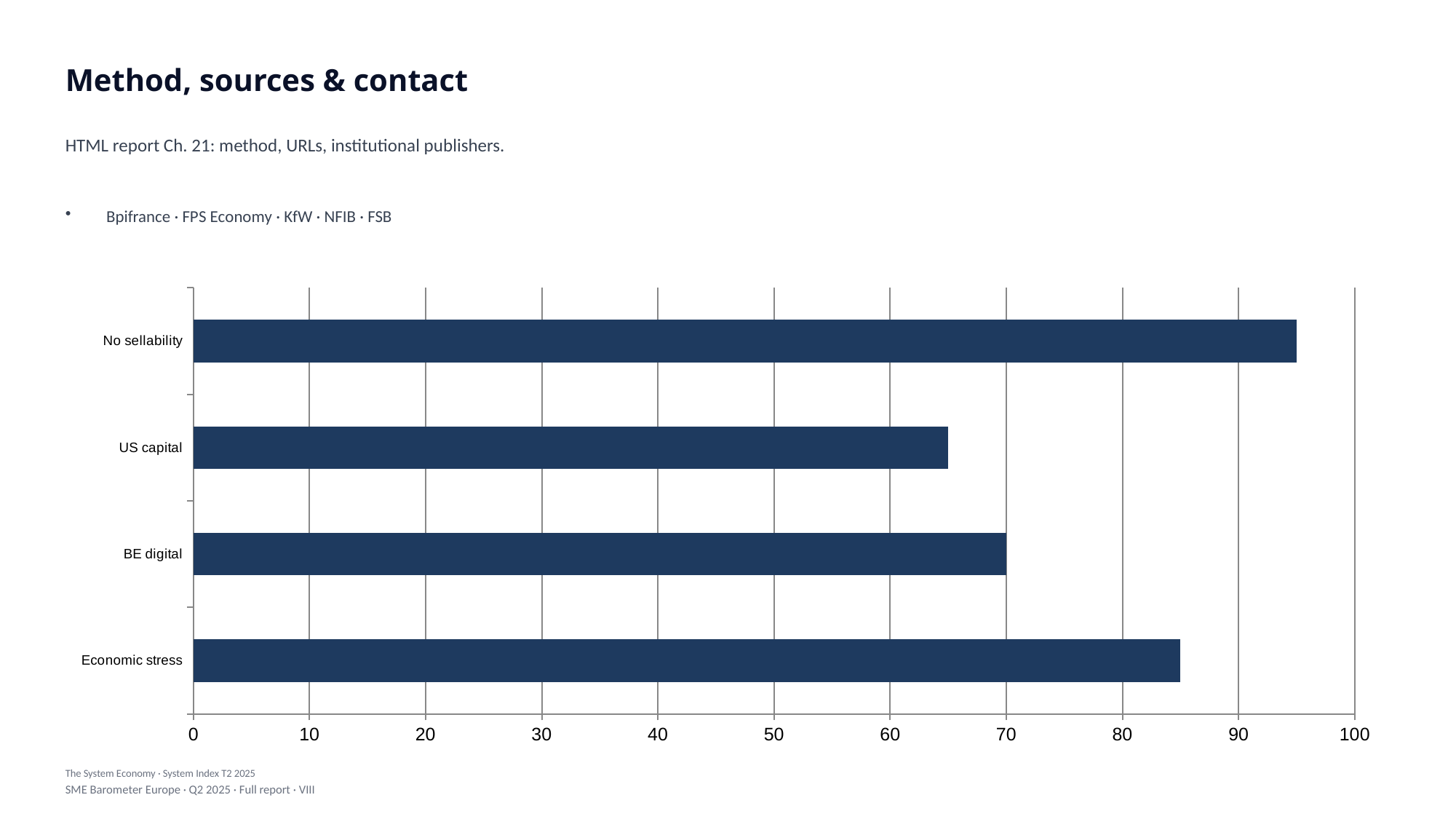
How many categories are plotted in the bar chart? 4 What is the maximum value shown on the horizontal axis of the chart? 100 Which category has the lowest value in the bar chart? US capital Is the value for US capital greater or less than 70? less Which category has the highest value in the bar chart? No sellability Is the value for Economic stress greater or less than 80? greater Which is larger, the value for Economic stress or the value for BE digital? Economic stress Is the value for No sellability greater or less than 90? greater Which is larger, the value for US capital or the value for No sellability? No sellability What kind of chart is shown on the slide? bar chart What is the value for BE digital? 70